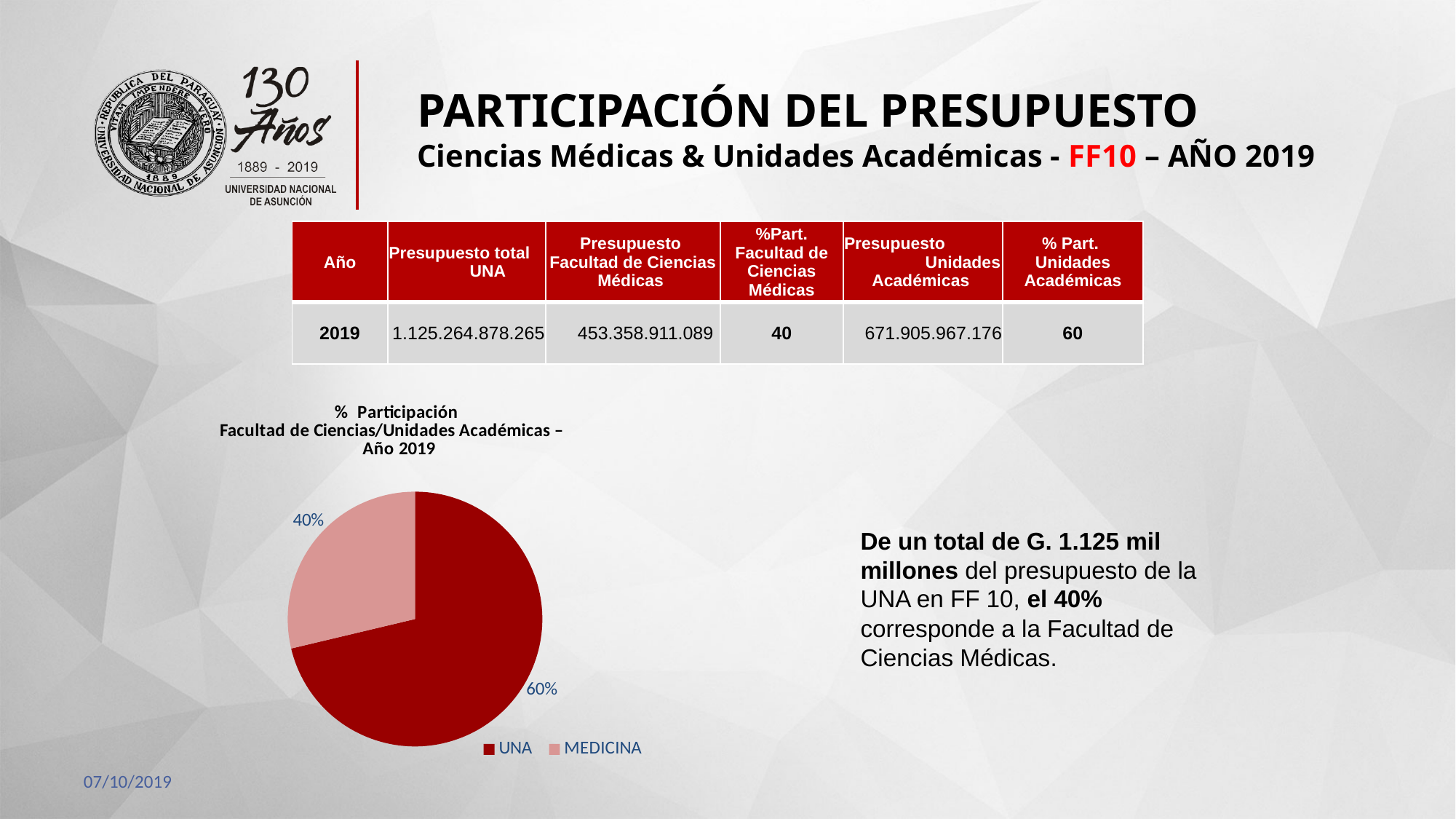
What share of the pie does the MEDICINA slice represent? 40% How many slices does the pie chart have? 2 What kind of chart is shown on the slide? pie chart Which is larger in the pie chart, UNA or MEDICINA? UNA What is the title of the pie chart? % Participación Facultad de Ciencias/Unidades Académicas – Año 2019 Which slice of the pie chart is the smallest? MEDICINA Is the value for MEDICINA greater or less than 50%? less How many entries does the pie chart legend list? 2 What share of the pie does the UNA slice represent? 60% What is the difference in percentage points between the UNA slice and the MEDICINA slice? 20% Which slice of the pie chart is the largest? UNA Which legend entry is shown in dark red in the pie chart? UNA